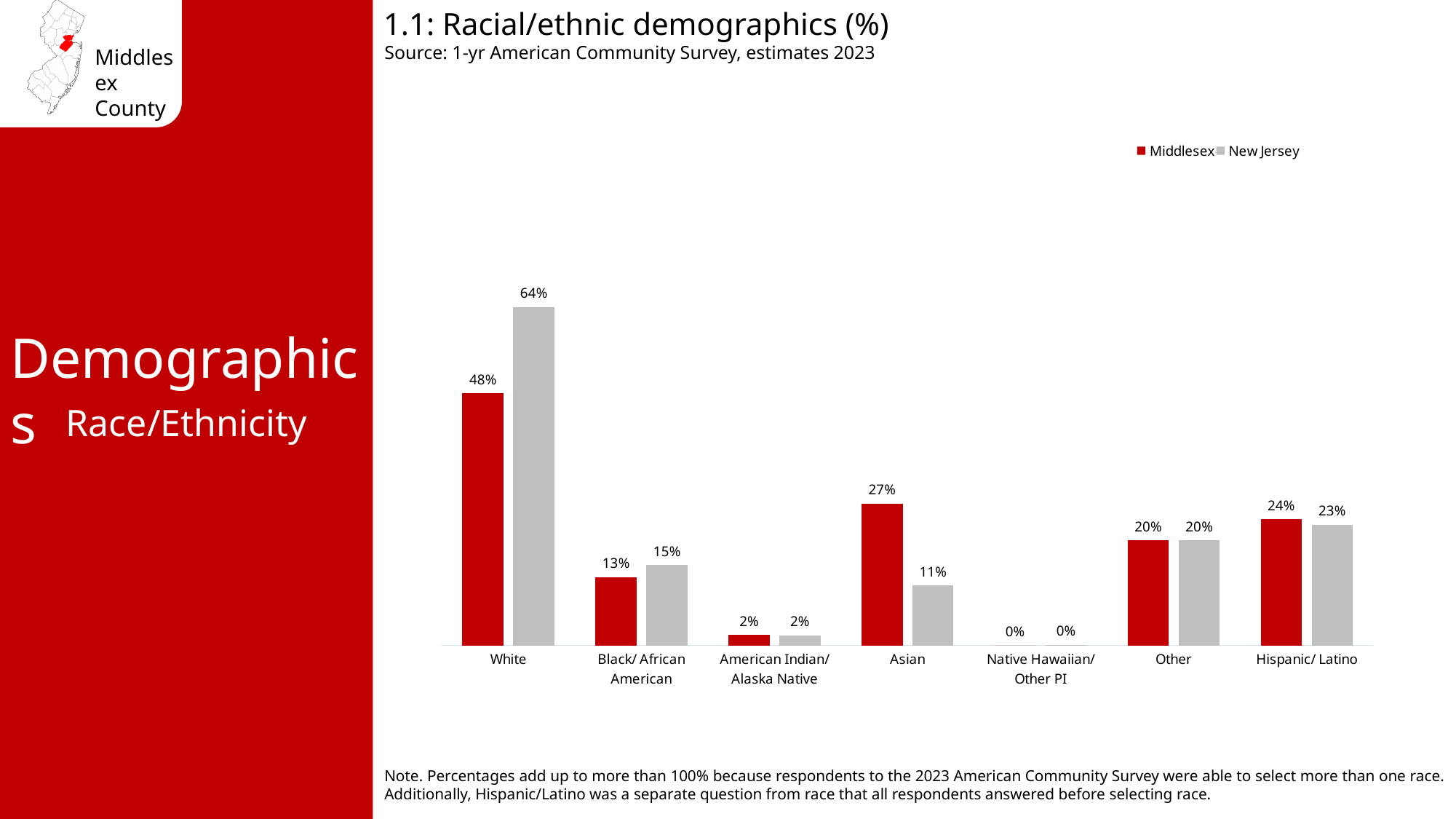
Which category has the highest New Jersey value? White What colour represents Middlesex in the chart? Red What is the difference between the New Jersey and Middlesex values for White? 16% Which category has the lowest Middlesex value? Native Hawaiian/ Other PI How many series does the legend list? 2 What is the Middlesex value for White? 48% What is the difference between the Middlesex and New Jersey values for Asian? 16% What is the New Jersey value for Asian? 11% What is the Middlesex value for Hispanic/ Latino? 24% How many categories are shown on the x axis? 7 What kind of chart is shown? Bar chart Which is larger for Black/ African American: Middlesex or New Jersey? New Jersey